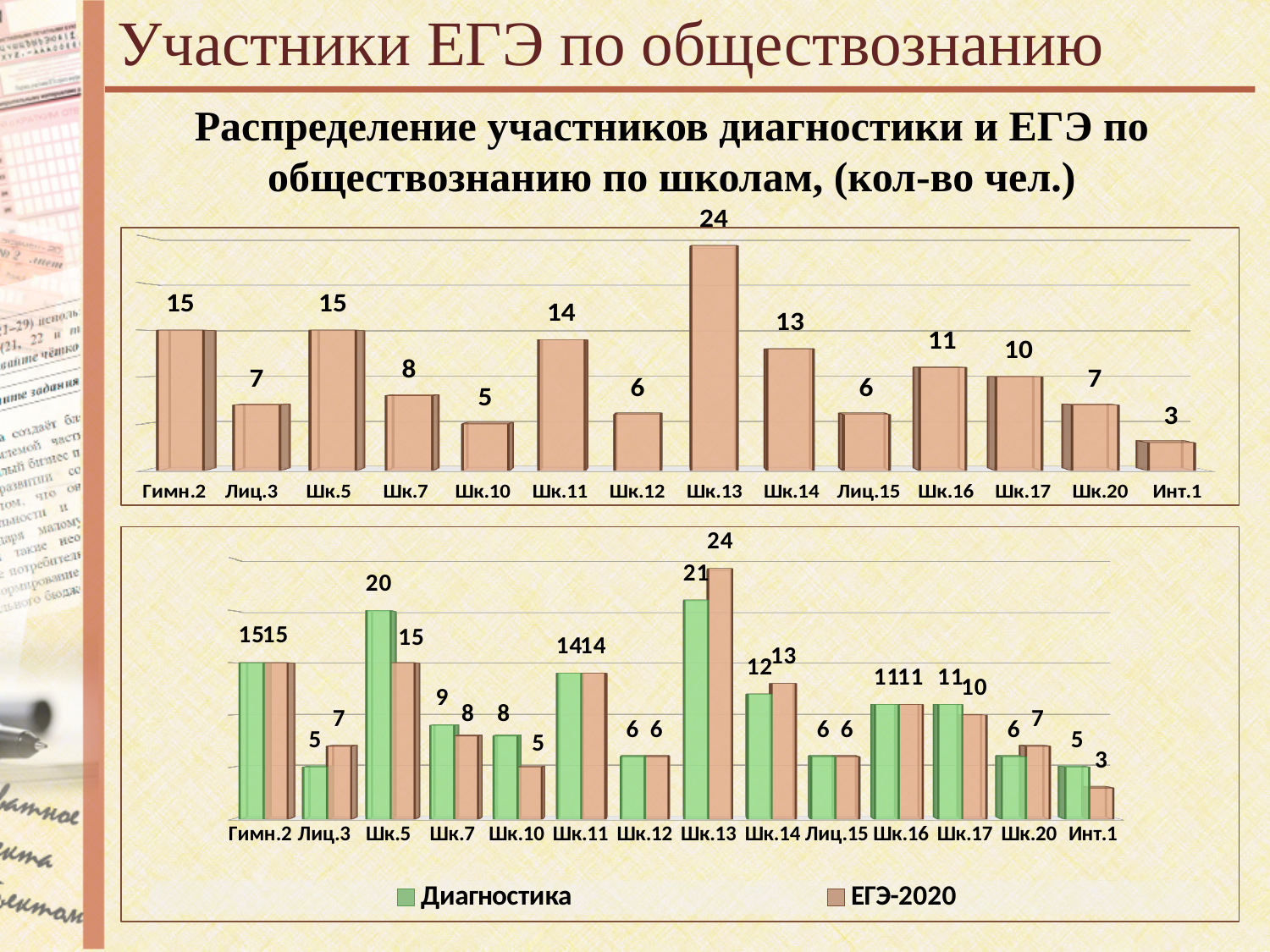
In the bottom chart, what is the Диагностика value for Шк.5? 20 In the top chart, what is the value for Шк.13? 24 In the top chart, how many categories are shown on the x axis? 14 In the bottom chart, what is the ЕГЭ-2020 value for Инт.1? 3 In the top chart, which category has the lowest value? Инт.1 In the top chart, what is the difference between the values for Шк.13 and Шк.14? 11 In the bottom chart, which series is shown in green? Диагностика In the bottom chart, which is larger for Шк.13: Диагностика or ЕГЭ-2020? ЕГЭ-2020 What kind of chart is the bottom chart? Bar chart How many series does the legend of the bottom chart list? 2 In the bottom chart, what is the difference between the Диагностика and ЕГЭ-2020 values for Шк.5? 5 In the bottom chart, which category has the highest ЕГЭ-2020 value? Шк.13